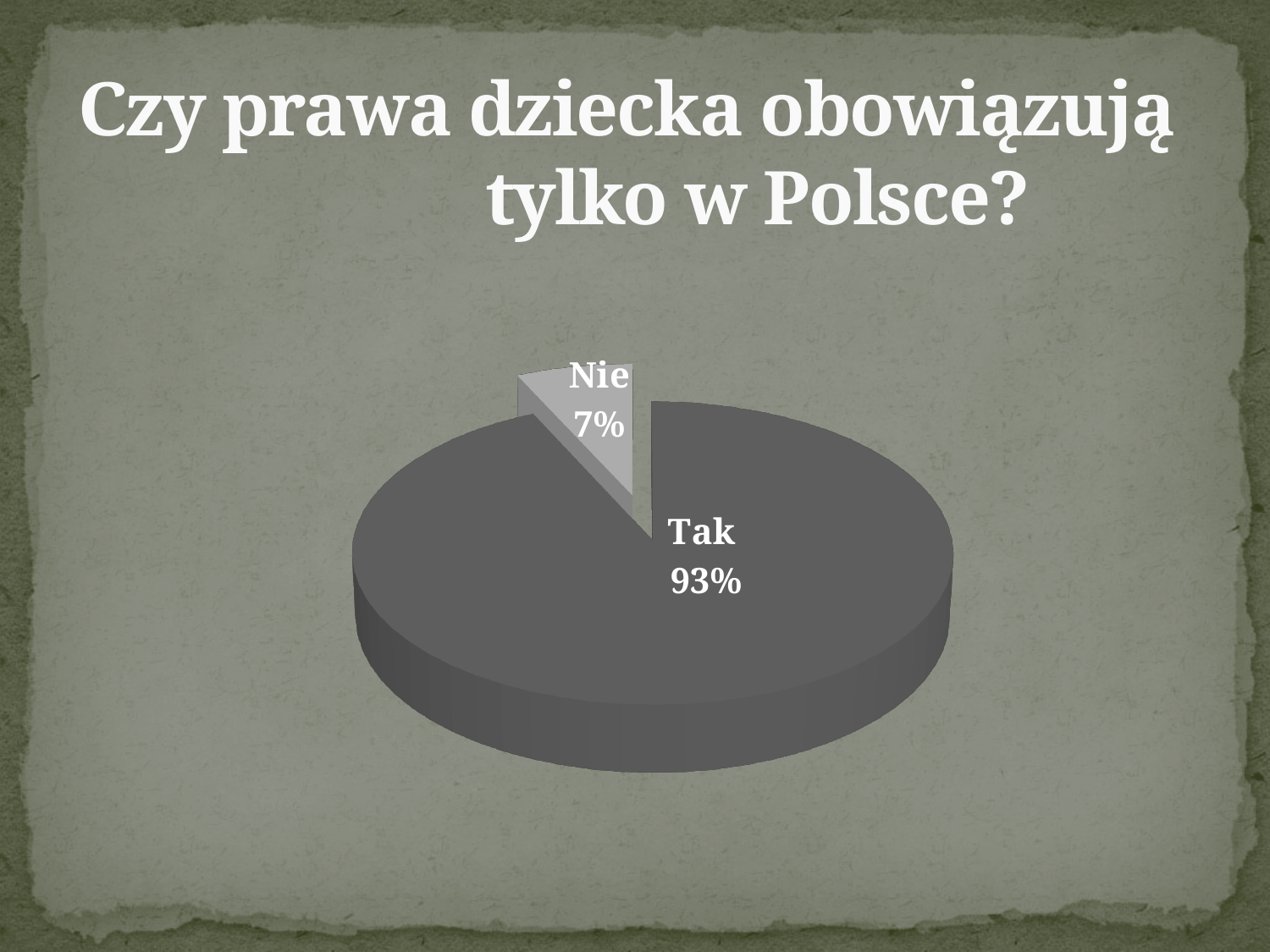
What is the difference in percentage points between the "Tak" and "Nie" slices? 86 What percentage of the pie is labelled "Tak"? 93% Which is larger, the "Tak" slice or the "Nie" slice? Tak How many slices does the pie chart have? 2 Which slice is shown in a lighter grey colour? Nie What is the title of the slide containing the pie chart? Czy prawa dziecka obowiązują tylko w Polsce? What share of the pie does the "Nie" slice represent? 7% What percentage of the pie is labelled "Nie"? 7% Which slice of the pie is the largest? Tak Which slice of the pie is the smallest? Nie What kind of chart is shown on the slide? pie chart